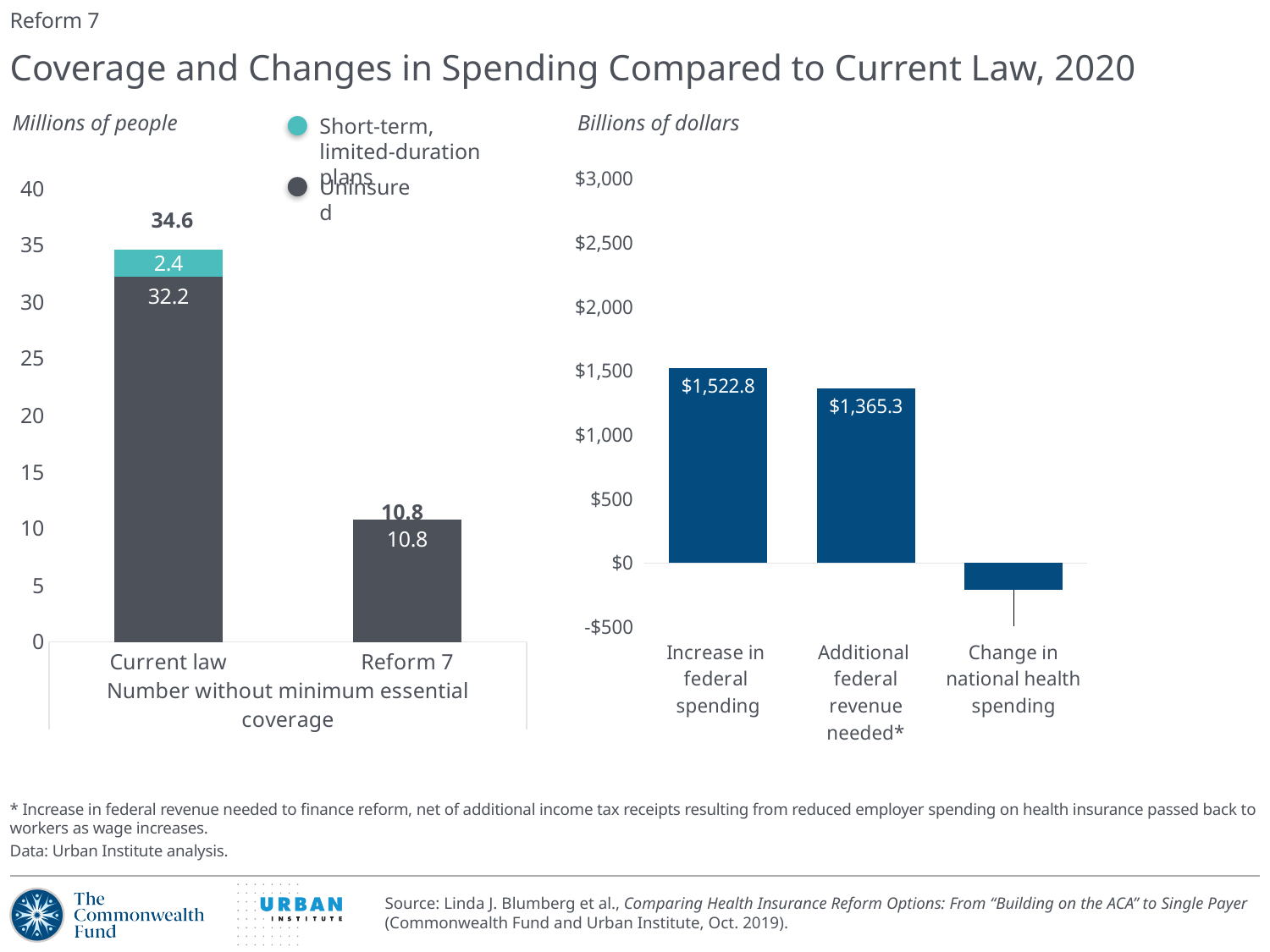
In the right chart (Billions of dollars), what is the value for Increase in federal spending? $1,522.8 In the left chart (Millions of people), which category has the higher total, Current law or Reform 7? Current law In the right chart (Billions of dollars), what is the difference between Increase in federal spending and Additional federal revenue needed? $157.5 In the right chart (Billions of dollars), how many categories are shown? 3 In the left chart (Millions of people), what is the difference between the Current law total and the Reform 7 total? 23.8 In the left chart (Millions of people), how many series does the legend list? 2 In the left chart (Millions of people), what is the value for Short-term, limited-duration plans under Current law? 2.4 In the right chart (Billions of dollars), what is the value for Additional federal revenue needed? $1,365.3 In the left chart (Millions of people), what is the Uninsured value for Current law? 32.2 In the left chart (Millions of people), what is the total for Reform 7? 10.8 In the right chart (Billions of dollars), is the value for Change in national health spending greater or less than $0? less In the left chart (Millions of people), what is the total of the stacked bar for Current law? 34.6